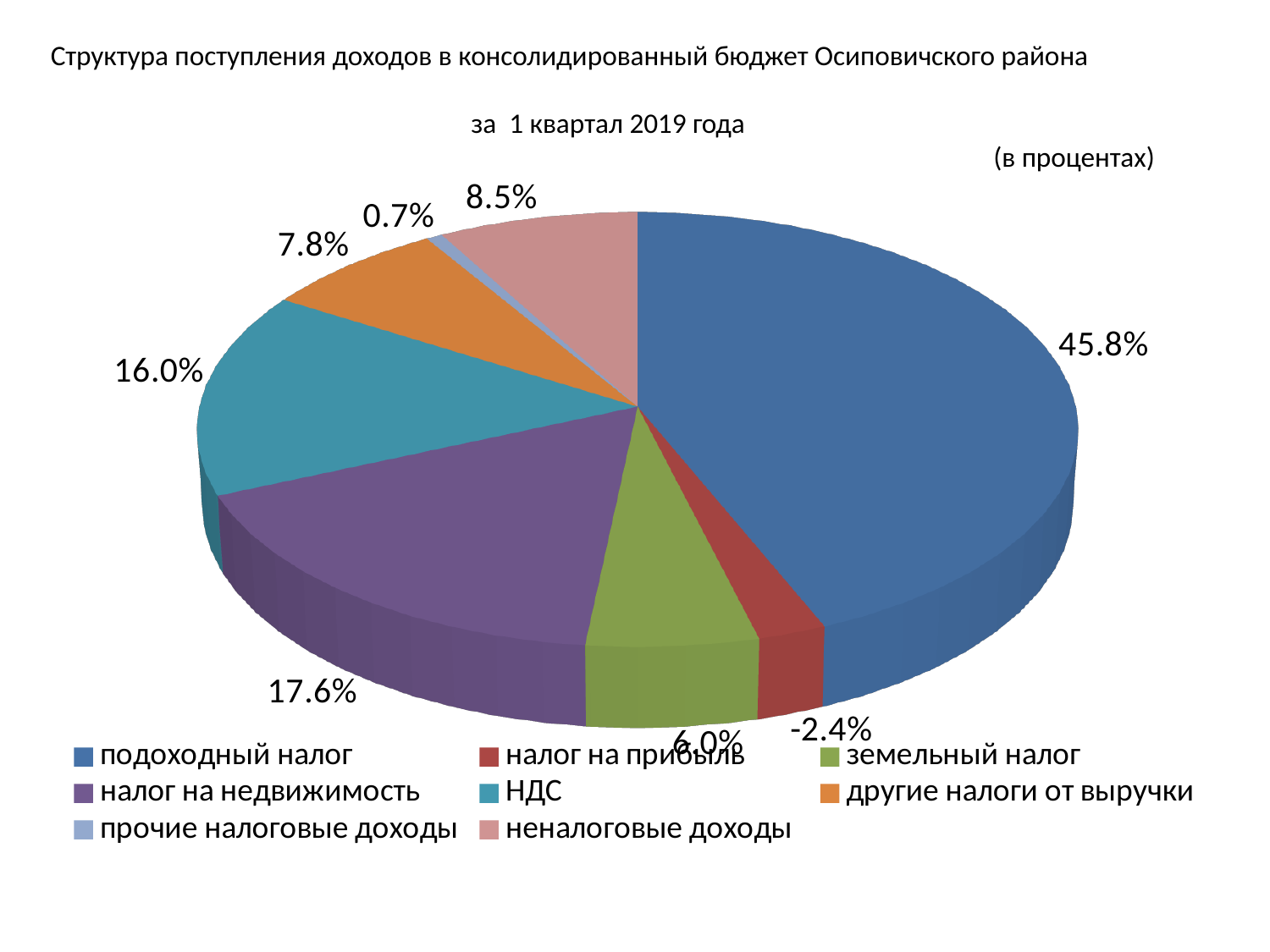
What value is shown for НДС? 16.0% What kind of chart is shown on the slide? pie chart What value is shown for неналоговые доходы? 8.5% What is the difference between the values for налог на недвижимость and НДС? 1.6% What share of the pie does подоходный налог account for? 45.8% Which of the two is larger: налог на недвижимость or НДС? налог на недвижимость Which category has the largest slice of the pie? подоходный налог What value is shown for налог на недвижимость? 17.6% What value is shown for другие налоги от выручки? 7.8% What value is shown for прочие налоговые доходы? 0.7% Which period does the chart title say the data covers? 1 квартал 2019 года How many categories does the legend list? 8